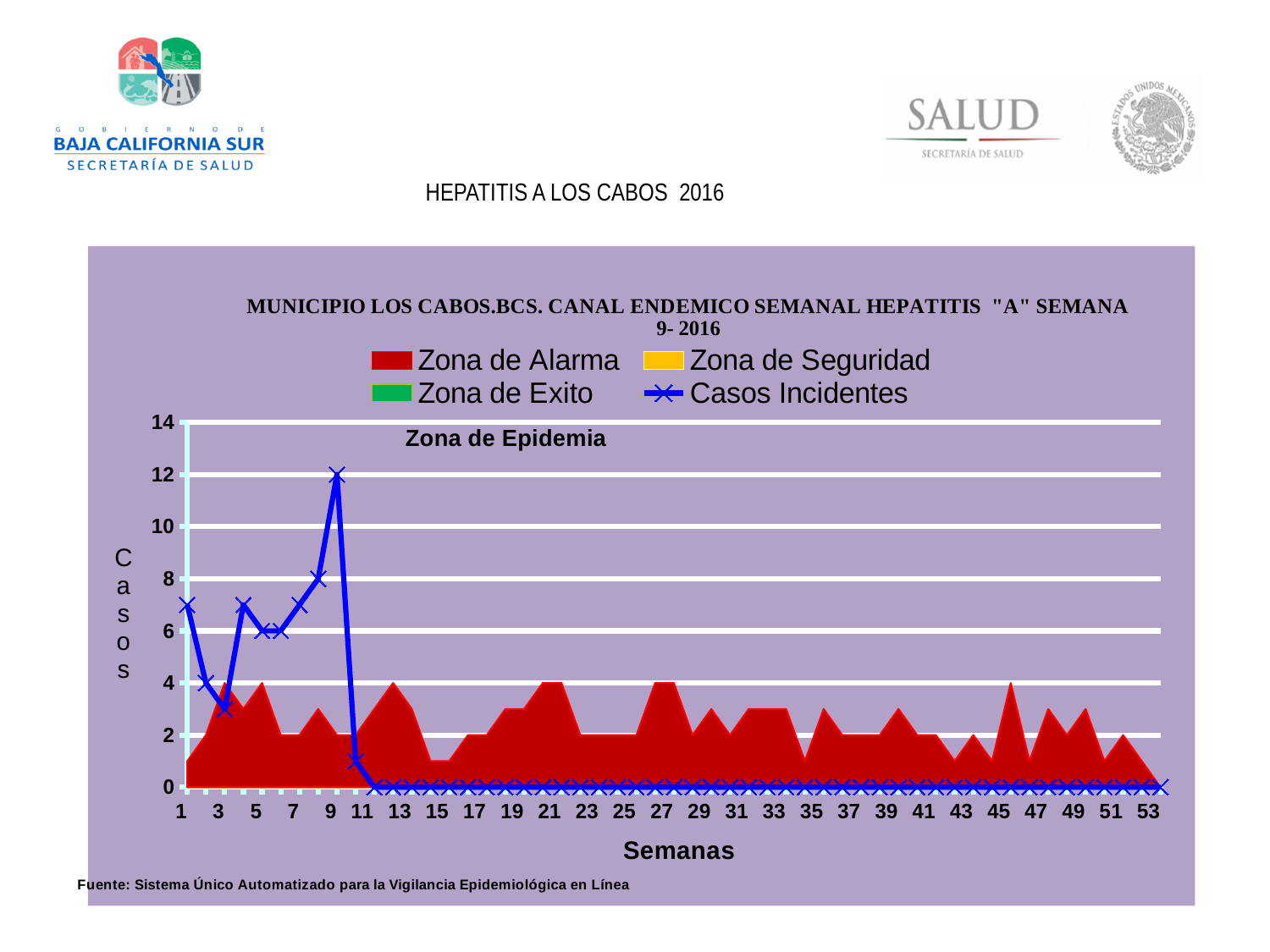
What is the value of Casos Incidentes in week 20? 0 In which week does the Casos Incidentes line reach its highest value? Week 9 Is the value of Casos Incidentes in week 10 greater or less than 2? less Which is larger, the Casos Incidentes value in week 9 or in week 4? Week 9 How many series does the legend list? 4 What is the value of Casos Incidentes in week 2? 4 What kind of chart is shown on the slide? Area chart with a line series What is the value of Casos Incidentes in week 9? 12 What label is shown on the x axis of the chart? Semanas What is the value of Casos Incidentes in week 8? 8 Is the value of Casos Incidentes in week 1 greater or less than 6? greater Does the Casos Incidentes line rise or fall between week 9 and week 11? Fall